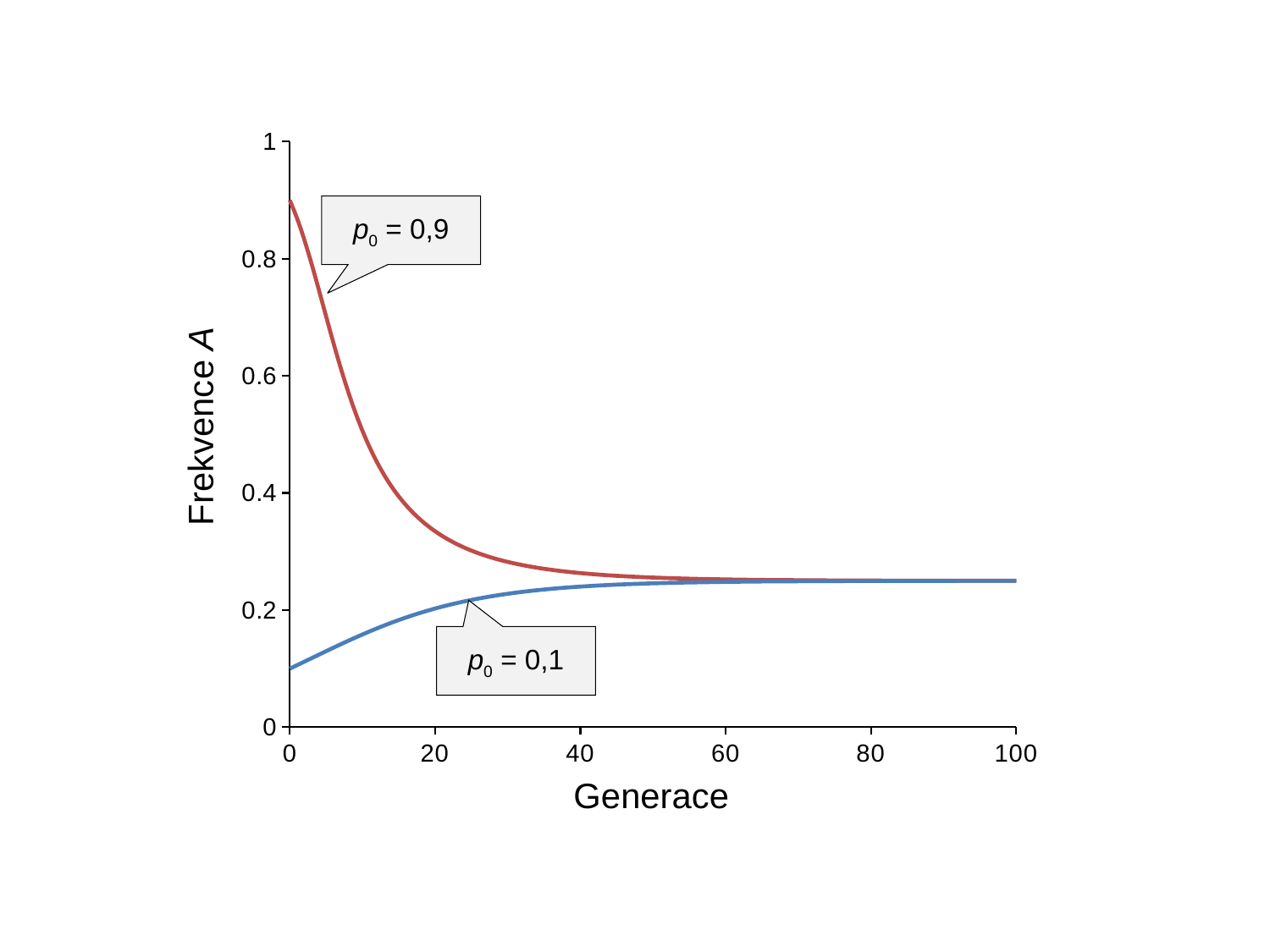
Is the value of the red line at generation 10 greater or less than 0.4? greater What is the starting frequency (p0) of the red line? 0,9 Is the value of the blue line at generation 100 greater or less than 0.2? greater Does the red line (p0 = 0,9) rise or fall as the number of generations increases? fall What is the difference between the starting frequencies of the red line (p0 = 0,9) and the blue line (p0 = 0,1)? 0,8 What is the starting frequency (p0) of the blue line? 0,1 How many lines (series) are plotted on the chart? 2 What kind of chart is shown on the slide? line chart Is the value of the red line at generation 20 greater or less than 0.4? less Does the blue line (p0 = 0,1) rise or fall as the number of generations increases? rise What is the label of the x axis? Generace At generation 20, which line has the higher frequency, the red line or the blue line? red line